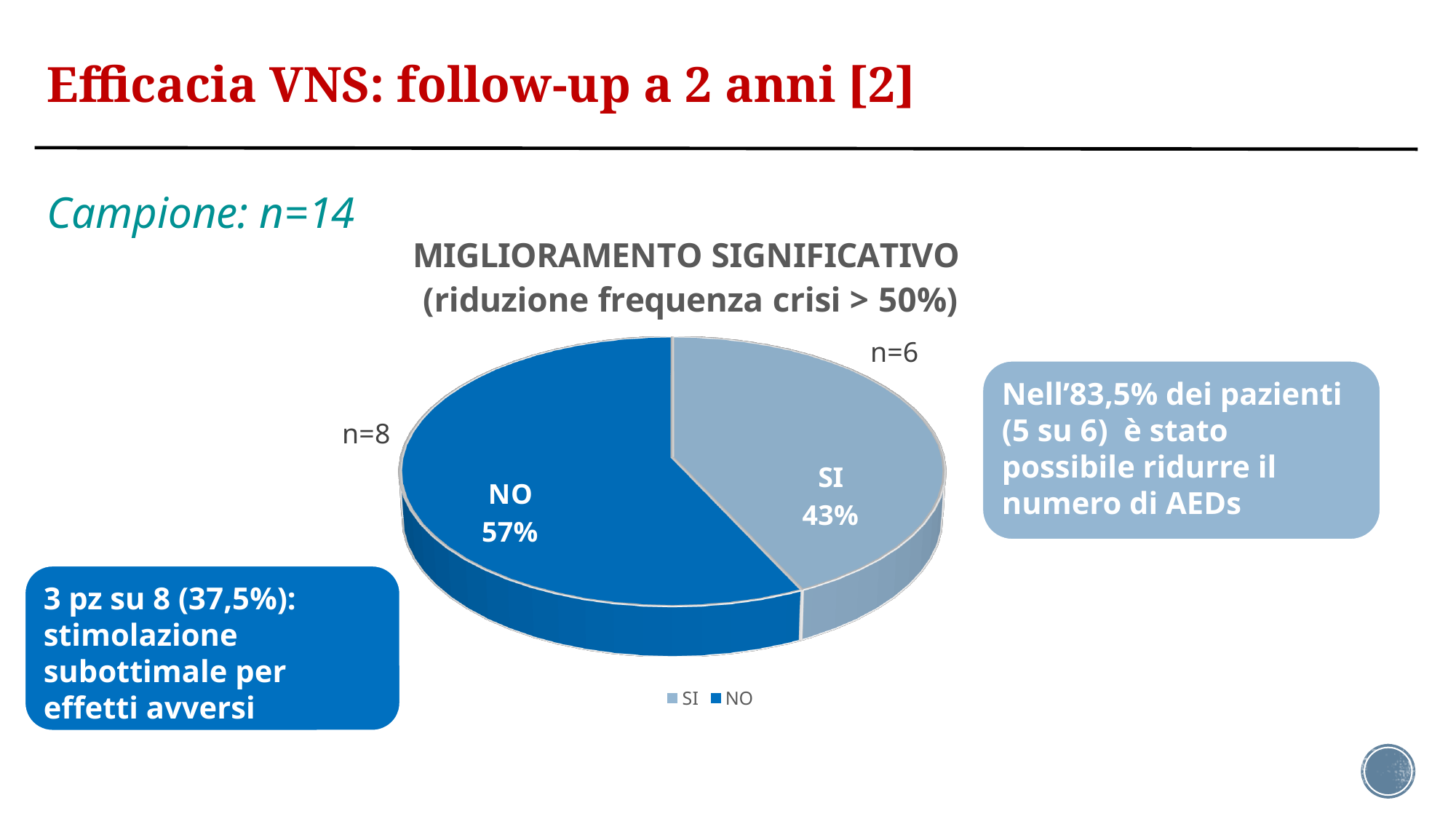
How many entries does the legend list? 2 What is the title of the pie chart? MIGLIORAMENTO SIGNIFICATIVO (riduzione frequenza crisi > 50%) Which category has the smallest share of the pie? SI How many slices does the pie chart have? 2 Which slice of the pie is larger, SI or NO? NO What is the difference in percentage points between the NO and SI slices? 14 What kind of chart is shown on the slide? pie chart How many patients (n) are in the NO slice? n=8 What percentage of the pie is labelled SI? 43% Which legend entry is shown in the darker blue colour? NO What percentage of the pie is labelled NO? 57% How many patients (n) are in the SI slice? n=6